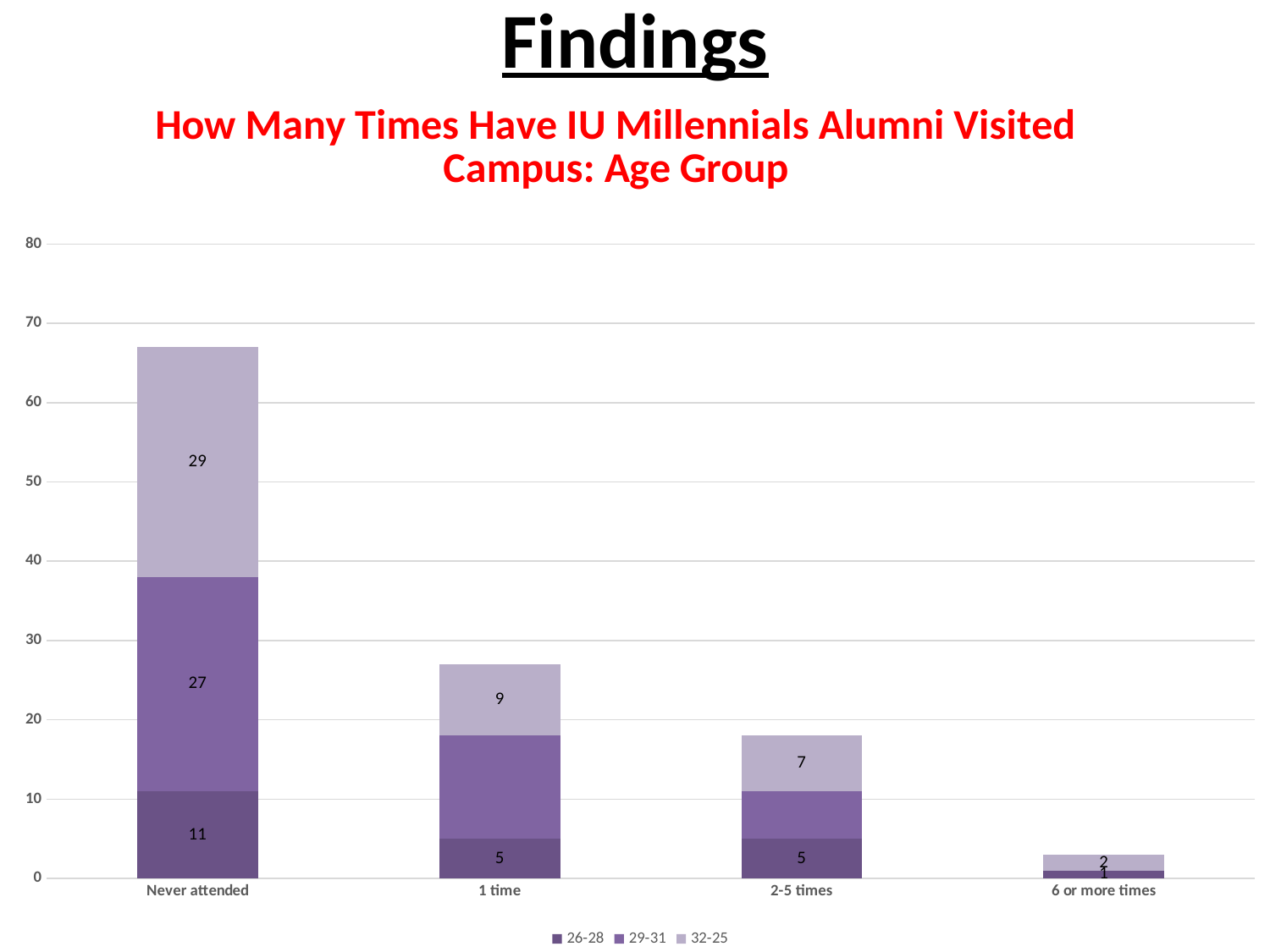
What kind of chart is shown on the slide? Stacked bar chart Is the total stacked bar for 1 time greater or less than 20? greater What is the total of the stacked bar for Never attended? 67 What is the value for the 26-28 series in the Never attended category? 11 What is the difference between the 32-25 and 26-28 values in the Never attended category? 18 What is the value for the 29-31 series in the Never attended category? 27 How many series does the legend list? 3 What is the value for the 32-25 series in the 1 time category? 9 How many categories are shown on the x axis? 4 Which category has the shortest stacked bar? 6 or more times What is the value for the 32-25 series in the 2-5 times category? 7 Which category has the tallest stacked bar? Never attended